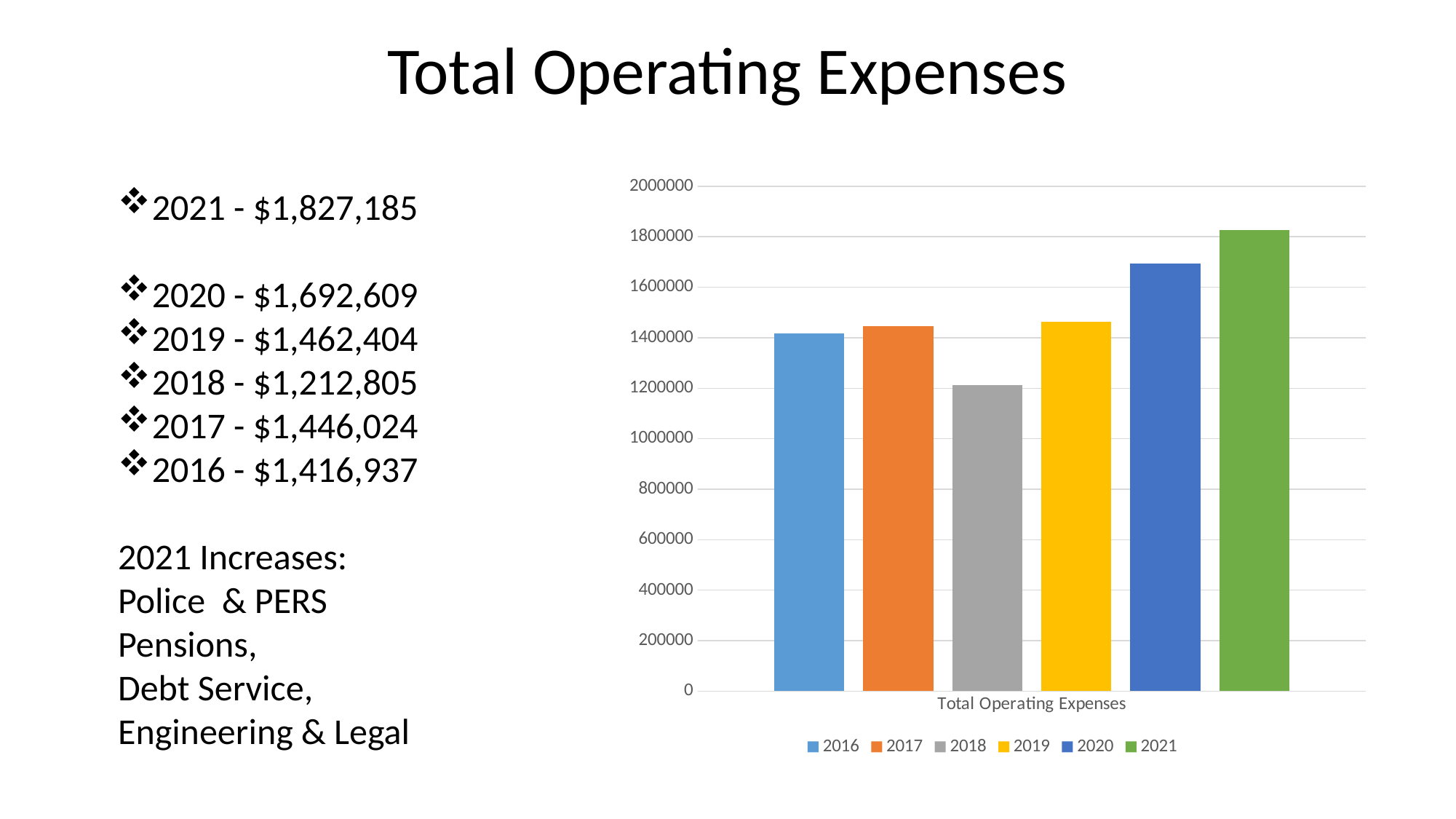
What is the total operating expenses value for 2021? $1,827,185 Which is larger, the bar for 2020 or the bar for 2019? 2020 Is the value for 2020 greater or less than 1800000? less Do the bars rise or fall from 2018 through 2021? Rise What kind of chart is shown on the slide? Bar chart Is the value for 2018 greater or less than 1400000? less Which year has the highest total operating expenses in the chart? 2021 What is the difference between the 2021 and 2020 total operating expenses? $134,576 What is the total operating expenses value for 2018? $1,212,805 How many series does the chart legend list? 6 What colour is the bar for 2021 in the chart? Green Which year has the lowest total operating expenses in the chart? 2018